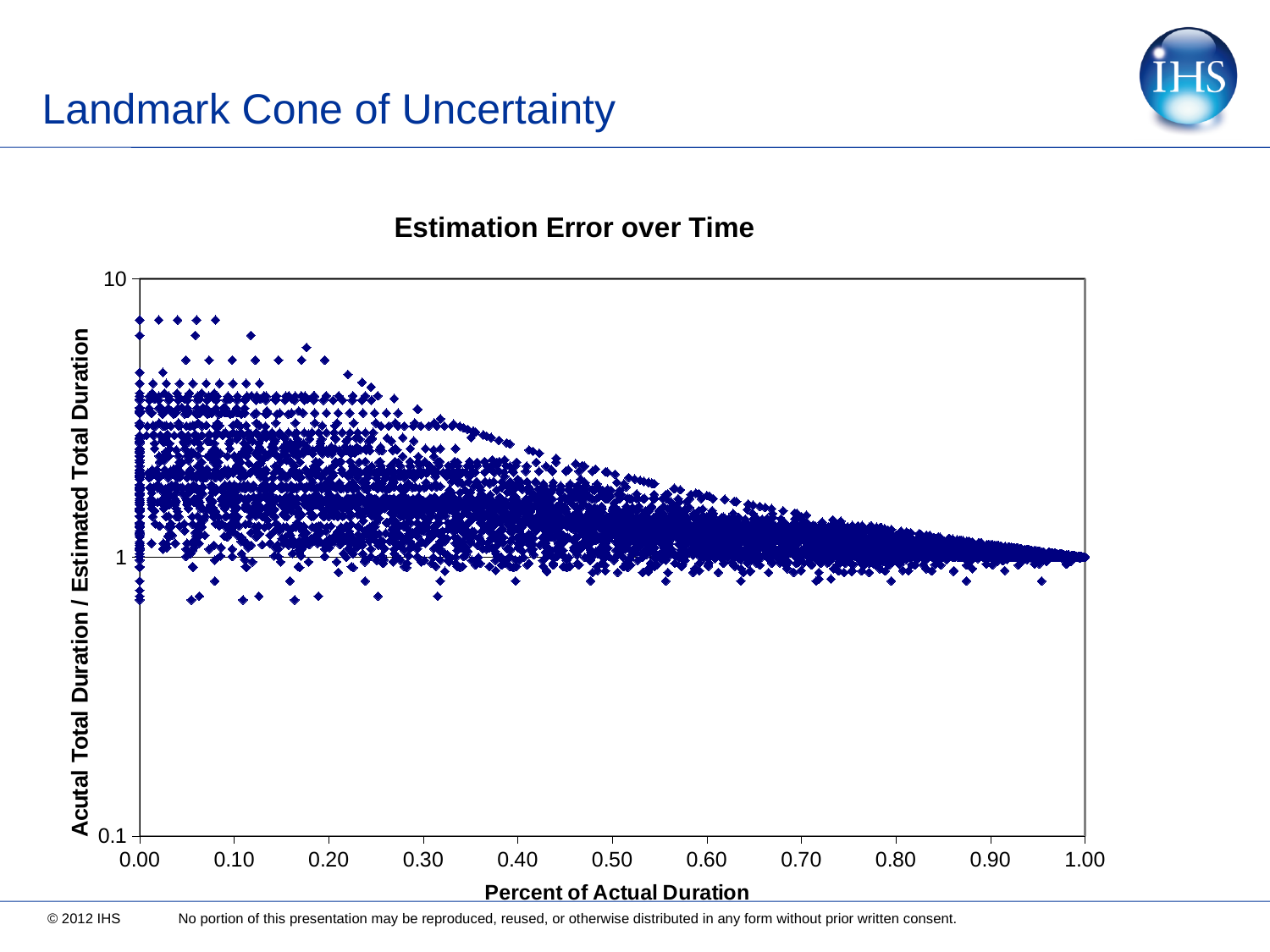
Are the highest points near a Percent of Actual Duration of 0.00 greater or less than 1? greater What is the title of the chart? Estimation Error over Time Toward what y-axis value do the points converge at a Percent of Actual Duration of 1.00? 1 As Percent of Actual Duration increases toward 1.00, does the vertical spread of the points widen or narrow? Narrow What is the minimum value shown on the y axis? 0.1 Are the highest plotted points greater or less than 10 on the y axis? less What is the label of the x axis? Percent of Actual Duration What is the maximum value shown on the y axis? 10 What is the maximum value shown on the x axis? 1.00 Are the points at a Percent of Actual Duration of 0.90 greater or less than 10? less What kind of chart is shown on the slide? Scatter chart